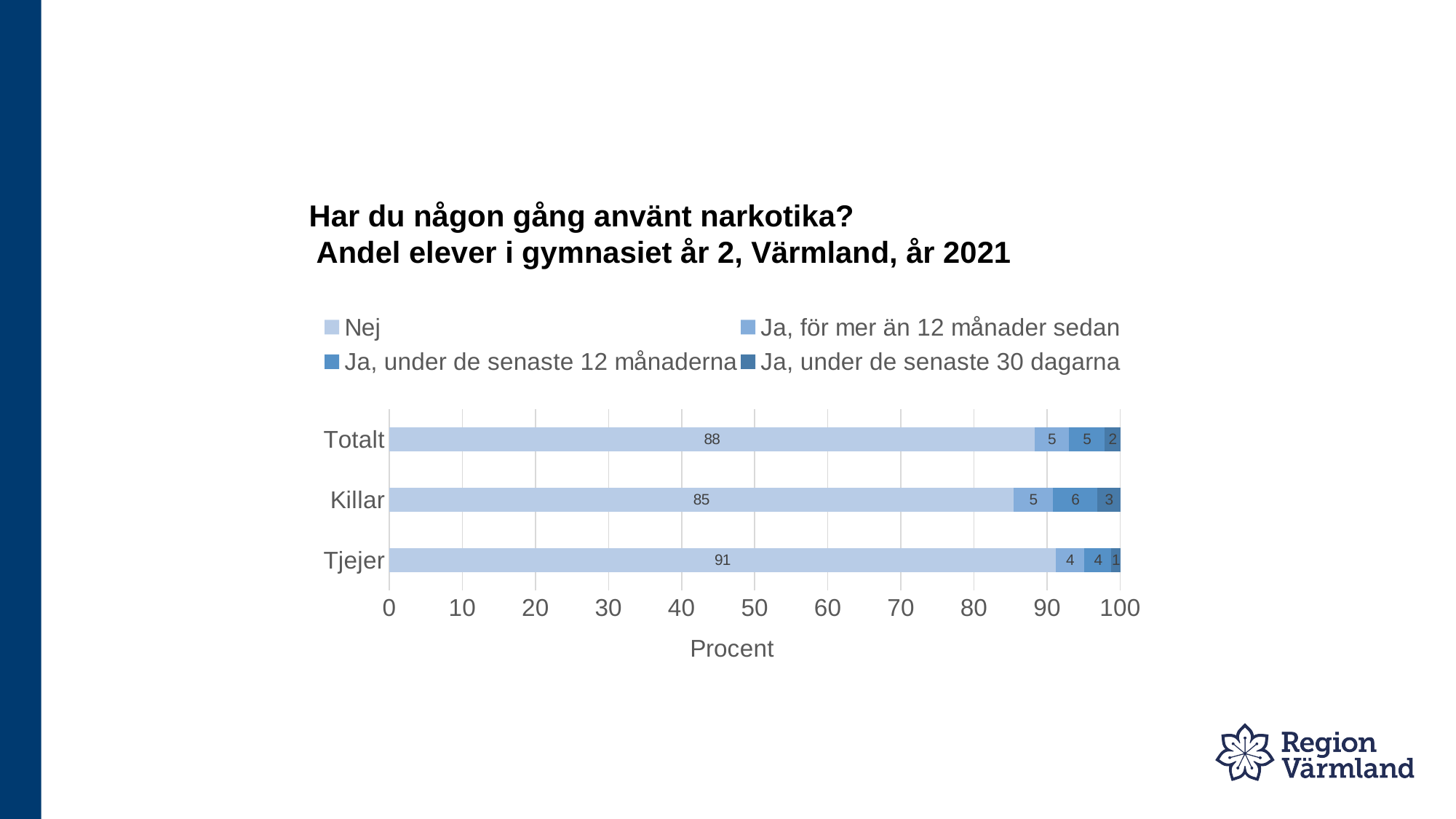
Which category has the lowest value for "Nej"? Killar How many series does the legend list? 4 How many categories are shown on the y axis? 3 What is the value for "Ja, under de senaste 30 dagarna" for Killar? 3 What is the label of the x axis? Procent Which category has the highest value for "Nej"? Tjejer What is the value for "Nej" for Tjejer? 91 What is the value for "Ja, under de senaste 12 månaderna" for Totalt? 5 What is the value for "Nej" for Killar? 85 What is the difference between the "Nej" values for Tjejer and Killar? 6 What kind of chart is shown on the slide? Stacked bar chart Which is larger: the "Ja, under de senaste 12 månaderna" value for Killar or for Tjejer? Killar